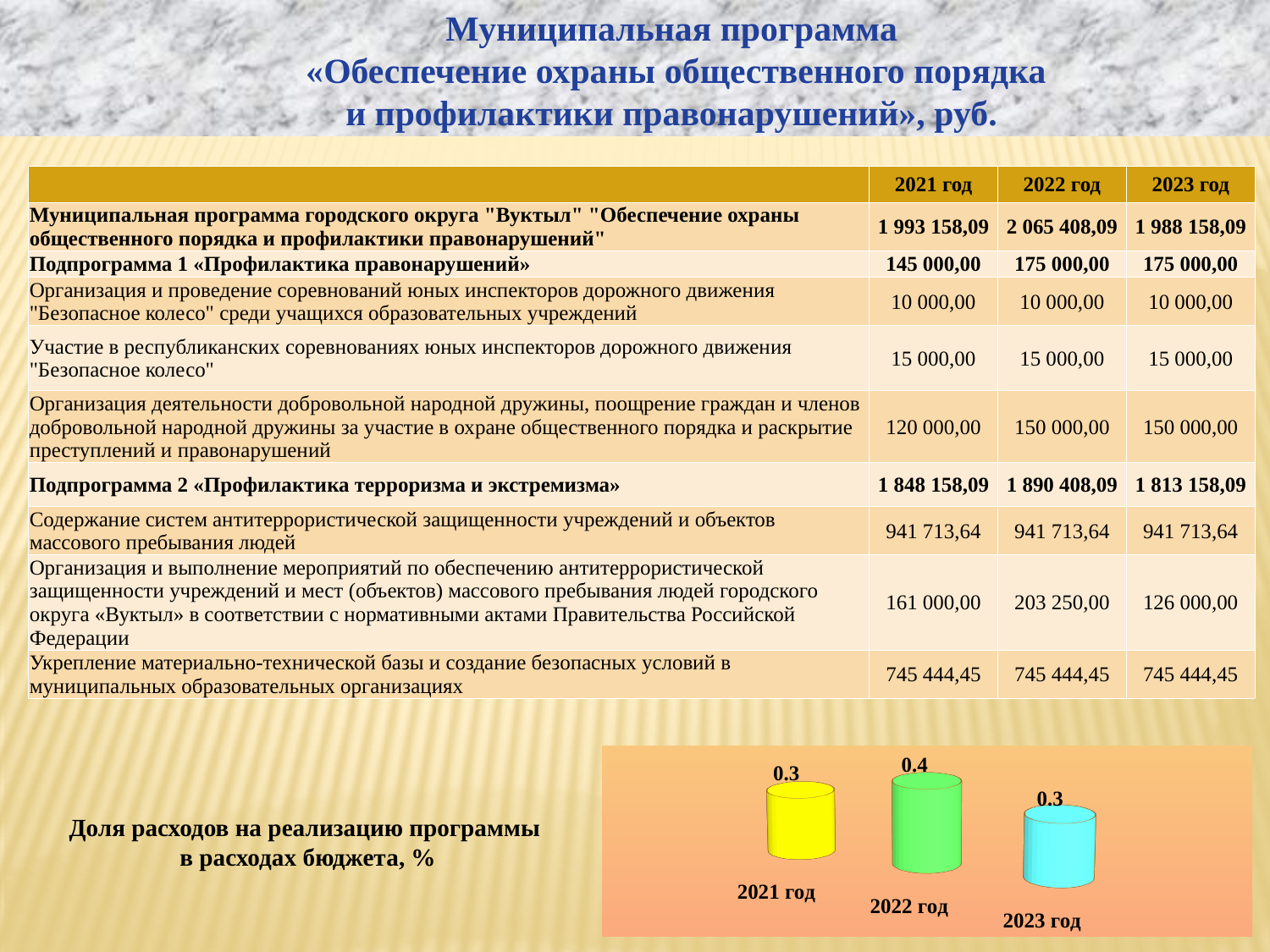
Which is larger in the chart, the value for 2021 год or the value for 2022 год? 2022 год What is the difference between the values for 2022 год and 2021 год in the chart? 0.1 What is the value shown for 2022 год in the chart? 0.4 What does the caption next to the chart say it shows? Доля расходов на реализацию программы в расходах бюджета, % What is the value shown for 2023 год in the chart? 0.3 What kind of chart is shown at the bottom of the slide? Bar chart What is the difference between the values for 2022 год and 2023 год in the chart? 0.1 Which year has the highest value in the chart? 2022 год What is the value shown for 2021 год in the chart? 0.3 What colour is the bar for 2022 год in the chart? Green Does the value in the chart rise or fall from 2022 год to 2023 год? Fall How many years are plotted in the chart? 3